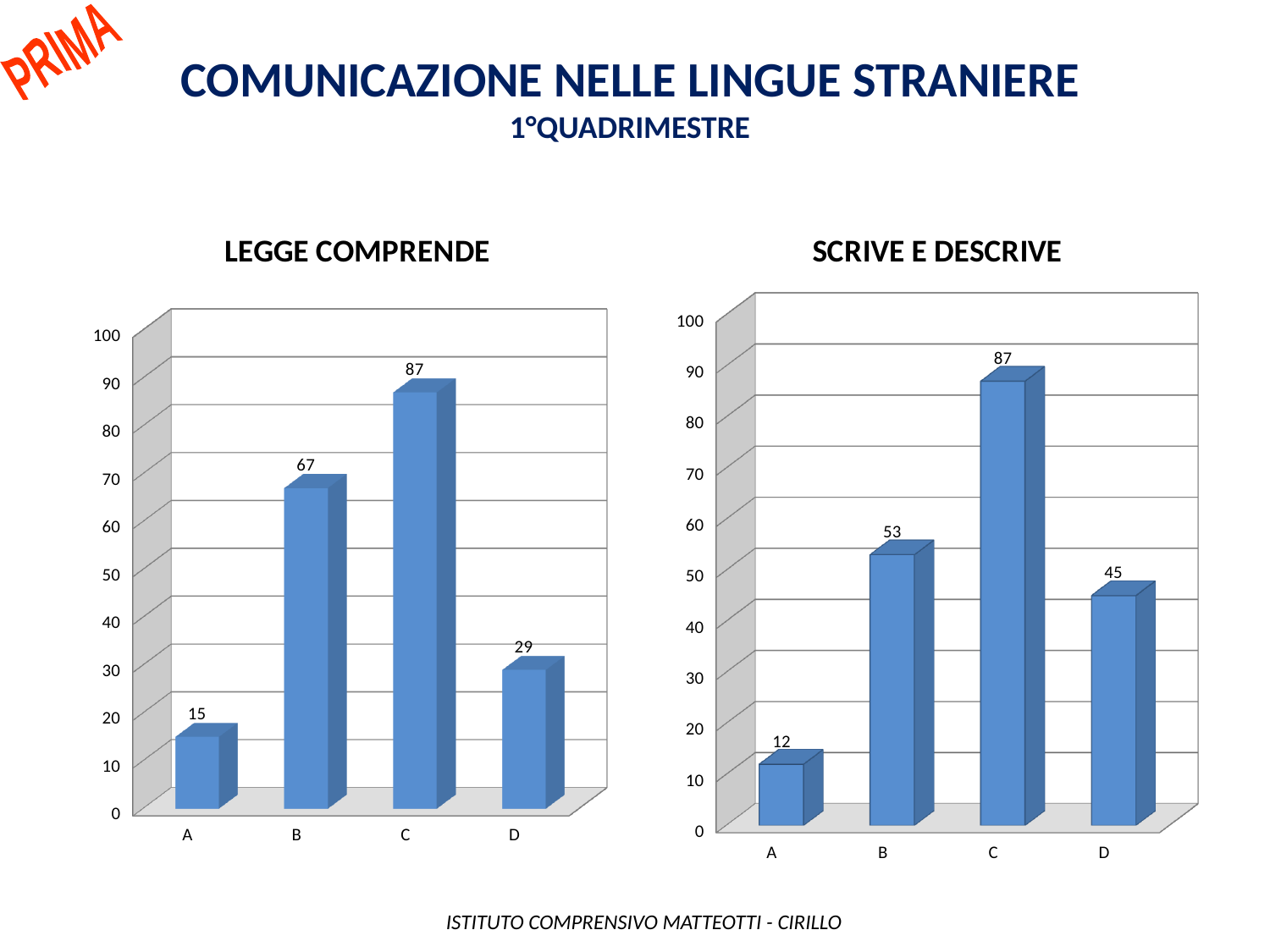
In the SCRIVE E DESCRIVE chart, which category has the highest value? C In the SCRIVE E DESCRIVE chart, what is the value for category D? 45 How many categories are shown in the SCRIVE E DESCRIVE chart? 4 In the LEGGE COMPRENDE chart, which category has the lowest value? A In the SCRIVE E DESCRIVE chart, what is the difference between the values for C and A? 75 What kind of chart is the LEGGE COMPRENDE chart? bar chart In the LEGGE COMPRENDE chart, what is the value for category A? 15 In the LEGGE COMPRENDE chart, is the value for B greater or less than 60? greater In the LEGGE COMPRENDE chart, what is the difference between the values for B and D? 38 In the SCRIVE E DESCRIVE chart, which is larger, the value for B or the value for D? B In the LEGGE COMPRENDE chart, what is the value for category C? 87 What is the title of the chart on the right side of the slide? SCRIVE E DESCRIVE